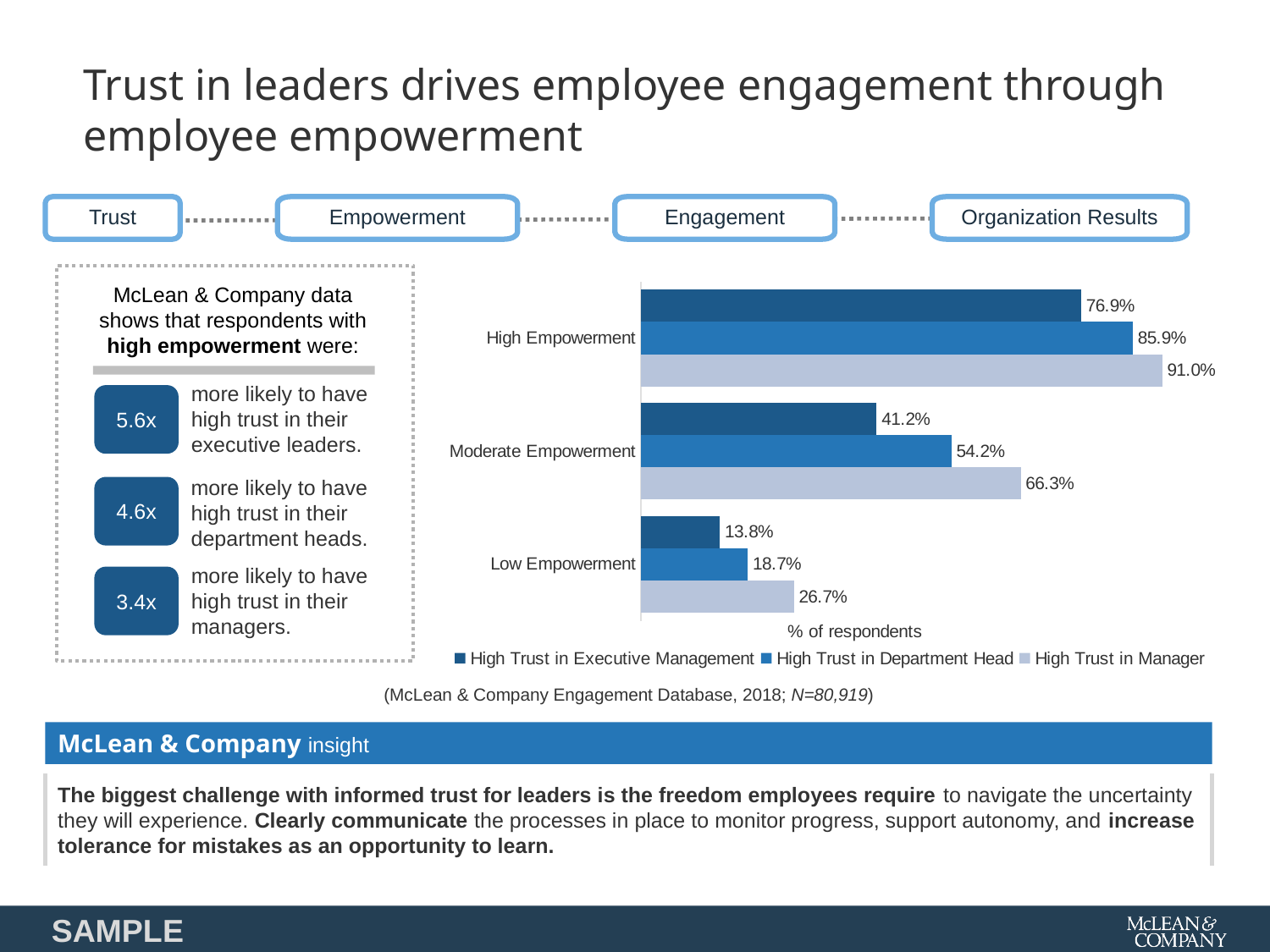
What is the label on the chart's value axis? % of respondents What is the value for High Trust in Executive Management among respondents with Moderate Empowerment? 41.2% What percentage of respondents with High Empowerment have High Trust in Manager? 91.0% Which empowerment category has the lowest value for High Trust in Manager? Low Empowerment What percentage of respondents with Low Empowerment have High Trust in Department Head? 18.7% What type of chart is shown on the slide? Bar chart For Low Empowerment, which is larger: High Trust in Executive Management or High Trust in Manager? High Trust in Manager How many series does the chart legend list? 3 Which empowerment category has the highest value for High Trust in Executive Management? High Empowerment What is the difference between High Trust in Department Head and High Trust in Executive Management for Moderate Empowerment? 13.0% How many empowerment categories are shown on the chart? 3 What is the difference between the High Trust in Manager values for High Empowerment and Low Empowerment? 64.3%